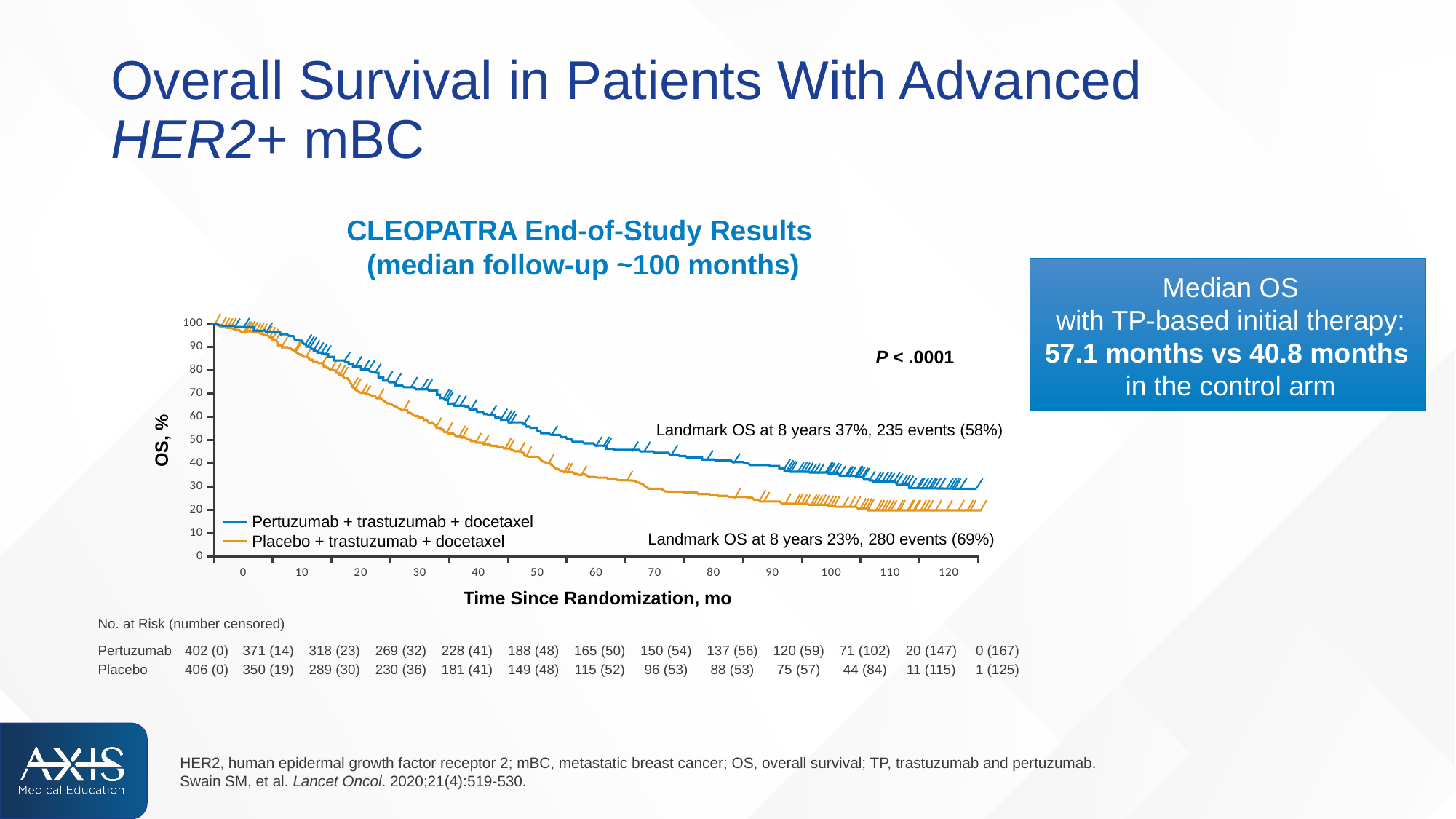
What is the landmark OS at 8 years for the Placebo + trastuzumab + docetaxel arm? 23% Do the OS curves rise or fall as time since randomization increases? Fall Is the OS value for the pertuzumab arm at 40 months greater or less than 60%? greater What is the landmark OS at 8 years for the Pertuzumab + trastuzumab + docetaxel arm? 37% What is the P value shown on the chart? P < .0001 How many events were recorded in the placebo arm? 280 (69%) What is the label of the x axis? Time Since Randomization, mo Is the OS value for the placebo arm at 100 months greater or less than 30%? less How many series does the legend list? 2 What is the difference in landmark OS at 8 years between the pertuzumab arm and the placebo arm? 14 percentage points Which arm has the higher overall survival curve across the time axis? Pertuzumab + trastuzumab + docetaxel What kind of chart is shown on the slide? Line chart (Kaplan-Meier survival curve)